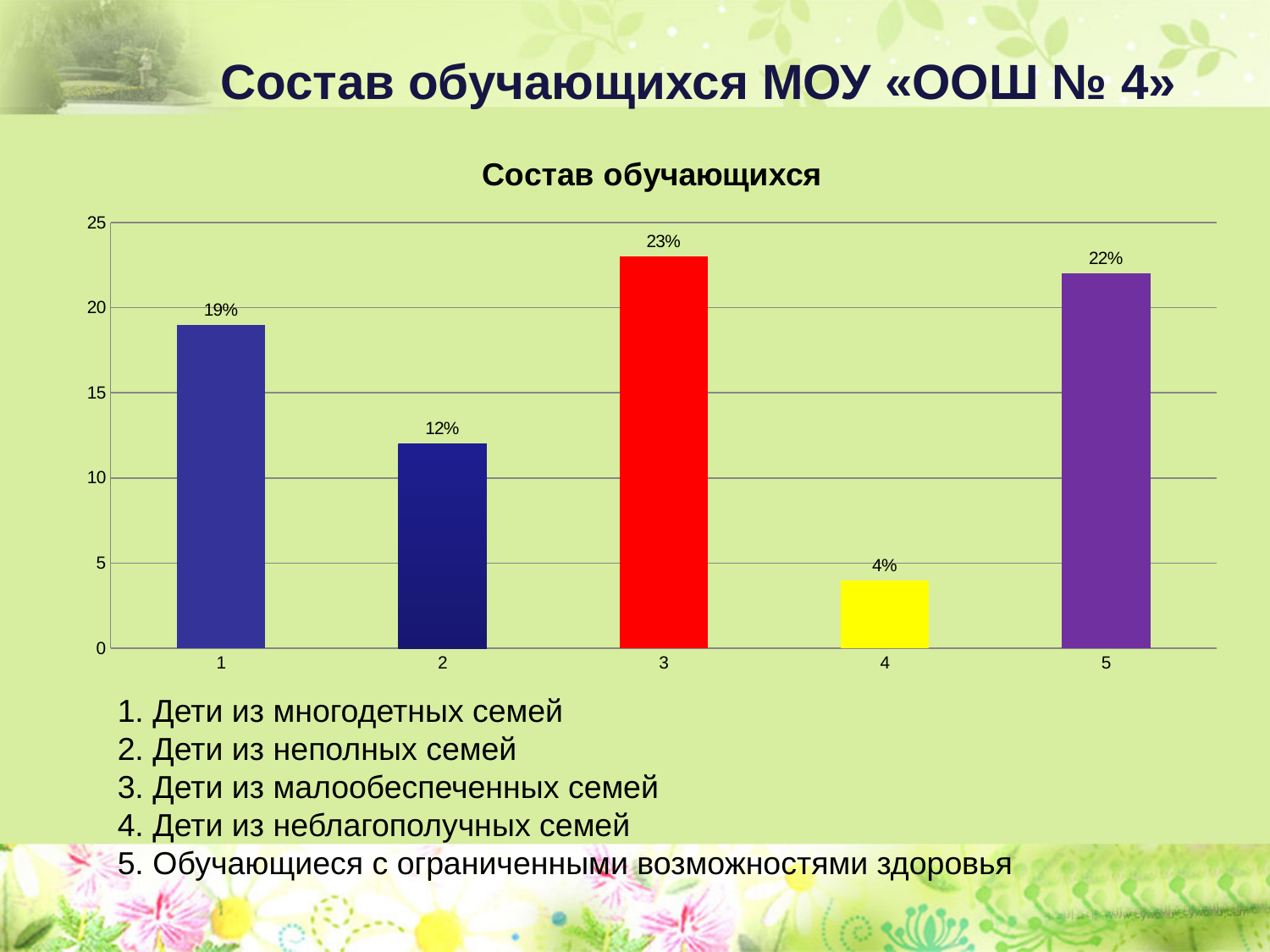
What is the value for category 1 in the chart? 19% What is the title of the chart? Состав обучающихся Which category has the lowest value in the chart? 4 What is the value for category 4 in the chart? 4% Is the value for category 2 greater or less than 15? less Which category has the highest value in the chart? 3 What is the difference between the values for category 3 and category 5? 1% Which is larger, the value for category 2 or the value for category 5? 5 How many categories are shown in the chart? 5 What kind of chart is shown on the slide? bar chart What is the difference between the values for category 1 and category 2? 7% What is the value for category 3 in the chart? 23%